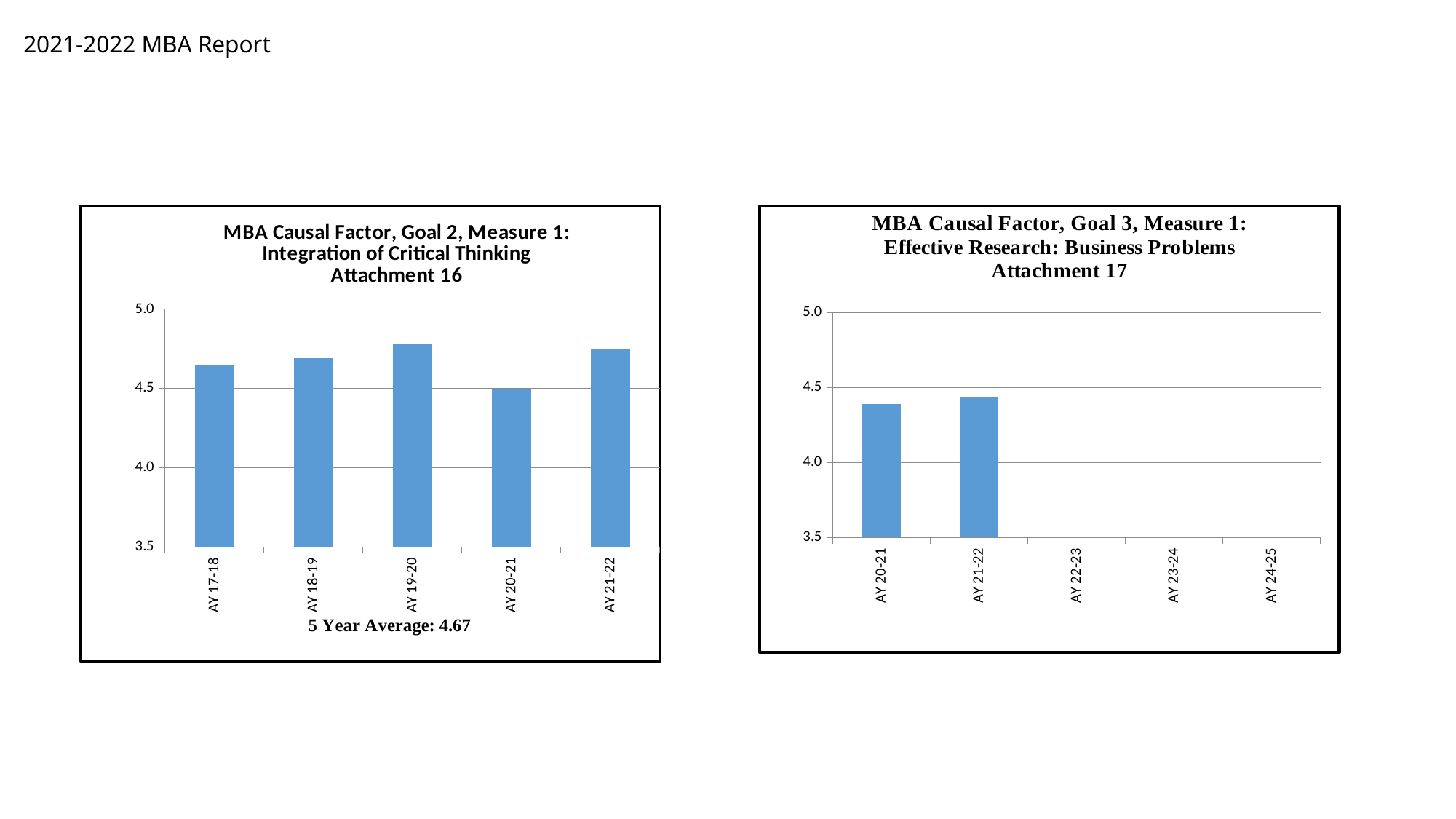
In the left chart (Goal 2, Measure 1), which is larger, the value for AY 19-20 or the value for AY 20-21? AY 19-20 In the left chart (Goal 2, Measure 1), is the value for AY 17-18 greater or less than 4.5? greater What 5 year average is printed below the left chart (Goal 2, Measure 1)? 4.67 In the left chart (Goal 2, Measure 1), is the value for AY 19-20 greater or less than 4.5? greater In the right chart (Goal 3, Measure 1), how many academic years have a bar plotted? 2 Which attachment number is given in the title of the right chart (Goal 3, Measure 1)? Attachment 17 In the right chart (Goal 3, Measure 1), is the value for AY 20-21 greater or less than 4.5? less How many academic years are shown on the x axis of the left chart (Goal 2, Measure 1)? 5 What kind of chart is the 'MBA Causal Factor, Goal 2, Measure 1' chart on the left? bar chart How many academic years are listed on the x axis of the right chart (Goal 3, Measure 1)? 5 In the left chart (Goal 2, Measure 1), which academic year has the lowest value? AY 20-21 What kind of chart is the 'MBA Causal Factor, Goal 3, Measure 1' chart on the right? bar chart